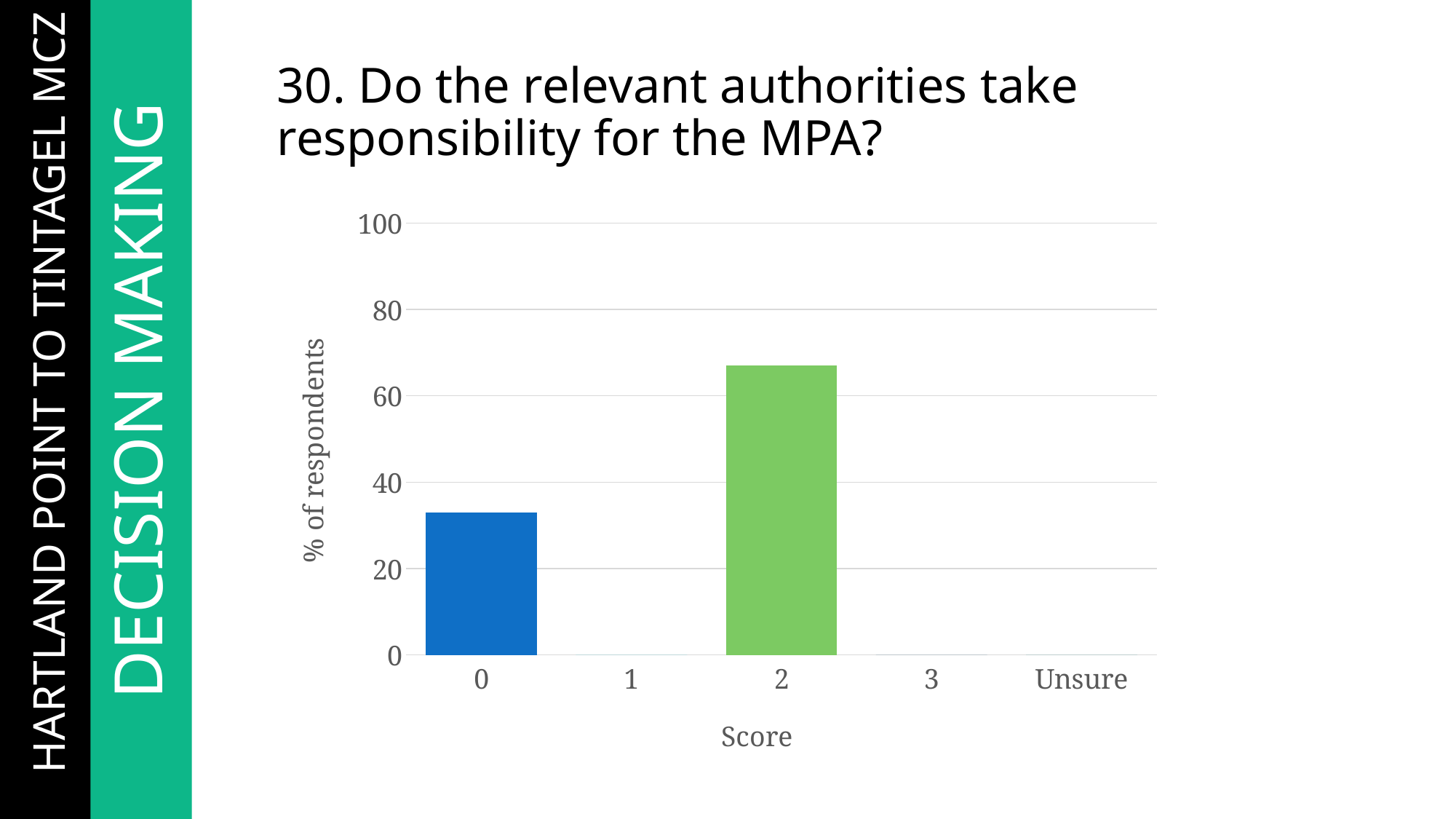
Is the value for score 2 greater or less than 60? greater Is the value for score 0 greater or less than 40? less How many score categories have a visible bar? 2 Which score has the highest percentage of respondents? 2 What is the label on the y axis? % of respondents How many score categories are shown on the x axis? 5 What kind of chart is shown on the slide? bar chart Is the value for score 0 greater or less than 20? greater What is the label on the x axis? Score Which has a larger percentage of respondents, score 0 or score 2? 2